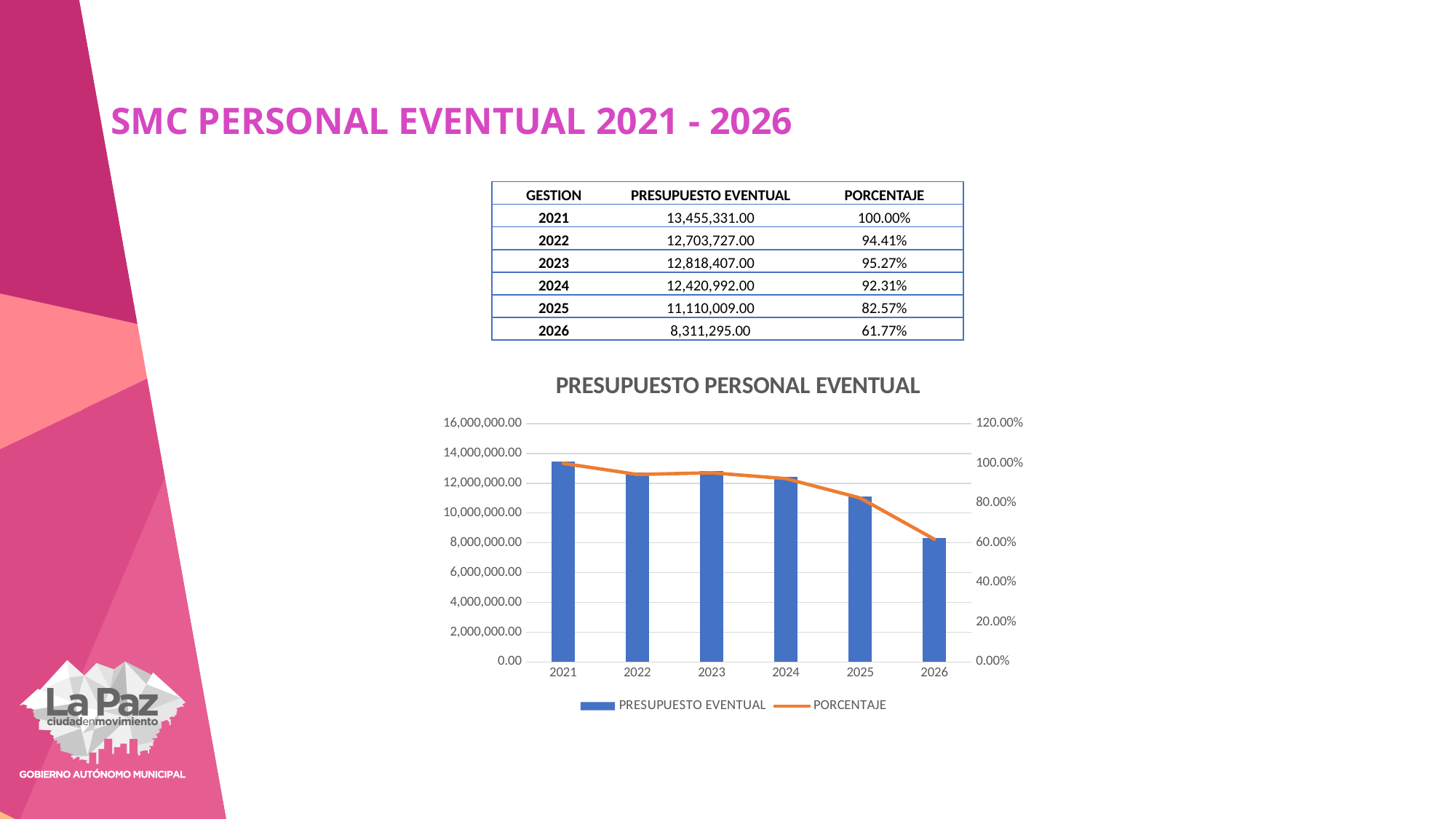
Which is larger, the PRESUPUESTO EVENTUAL for 2023 or for 2025? 2023 How many series does the chart legend list? 2 What PORCENTAJE is shown for 2025? 82.57% What is the overall trend of the PORCENTAJE line from 2021 to 2026? Falling What type of chart is shown under the title PRESUPUESTO PERSONAL EVENTUAL? Bar chart with a line series Is the PRESUPUESTO EVENTUAL bar for 2021 greater or less than 12,000,000.00? greater What is the PRESUPUESTO EVENTUAL for 2024 as printed on the slide? 12,420,992.00 How many years are plotted on the x axis of the chart? 6 What colour are the PRESUPUESTO EVENTUAL bars in the chart? Blue Which year has the lowest PRESUPUESTO EVENTUAL? 2026 Which year has the highest PRESUPUESTO EVENTUAL? 2021 Is the PRESUPUESTO EVENTUAL bar for 2026 greater or less than 10,000,000.00? less